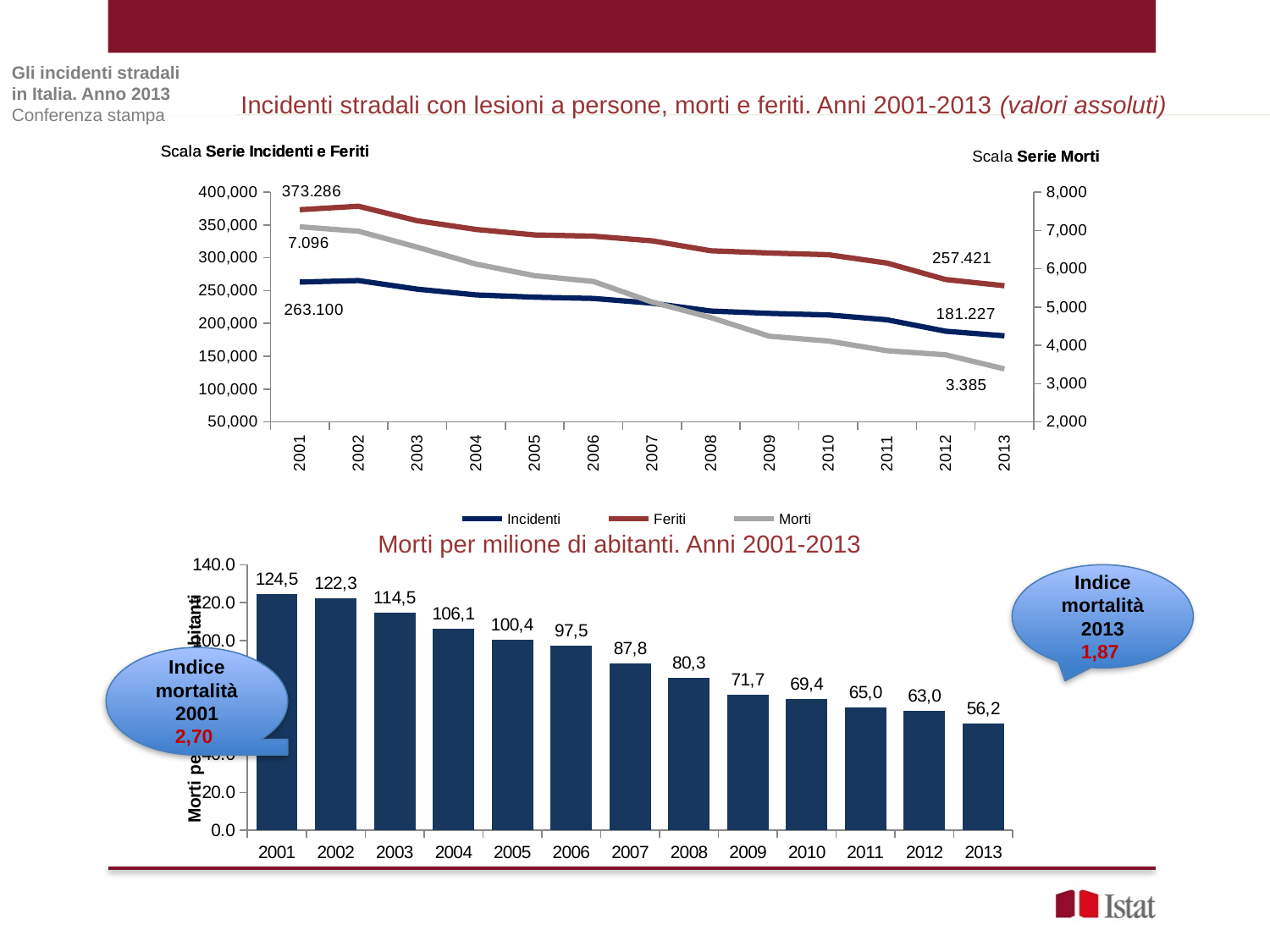
In the bottom chart 'Morti per milione di abitanti', what kind of chart is it? Bar chart In the bottom chart 'Morti per milione di abitanti', which year has the lowest value? 2013 In the top chart 'Incidenti stradali con lesioni a persone, morti e feriti', what is the value of the Incidenti series in 2013? 181.227 In the top chart 'Incidenti stradali con lesioni a persone, morti e feriti', by how much did the Feriti series fall from 2001 to 2013? 115.865 In the bottom chart 'Morti per milione di abitanti', what is the value for 2007? 87,8 In the bottom chart 'Morti per milione di abitanti', how many years are shown? 13 In the top chart 'Incidenti stradali con lesioni a persone, morti e feriti', does the Morti series rise or fall from 2001 to 2013? Fall In the top chart 'Incidenti stradali con lesioni a persone, morti e feriti', what is the value of the Feriti series in 2001? 373.286 In the top chart 'Incidenti stradali con lesioni a persone, morti e feriti', what is the value of the Morti series in 2013? 3.385 In the bottom chart 'Morti per milione di abitanti', what is the difference between the 2001 and 2013 values? 68,3 In the top chart 'Incidenti stradali con lesioni a persone, morti e feriti', how many series does the legend list? 3 In the top chart 'Incidenti stradali con lesioni a persone, morti e feriti', what kind of chart is it? Line chart